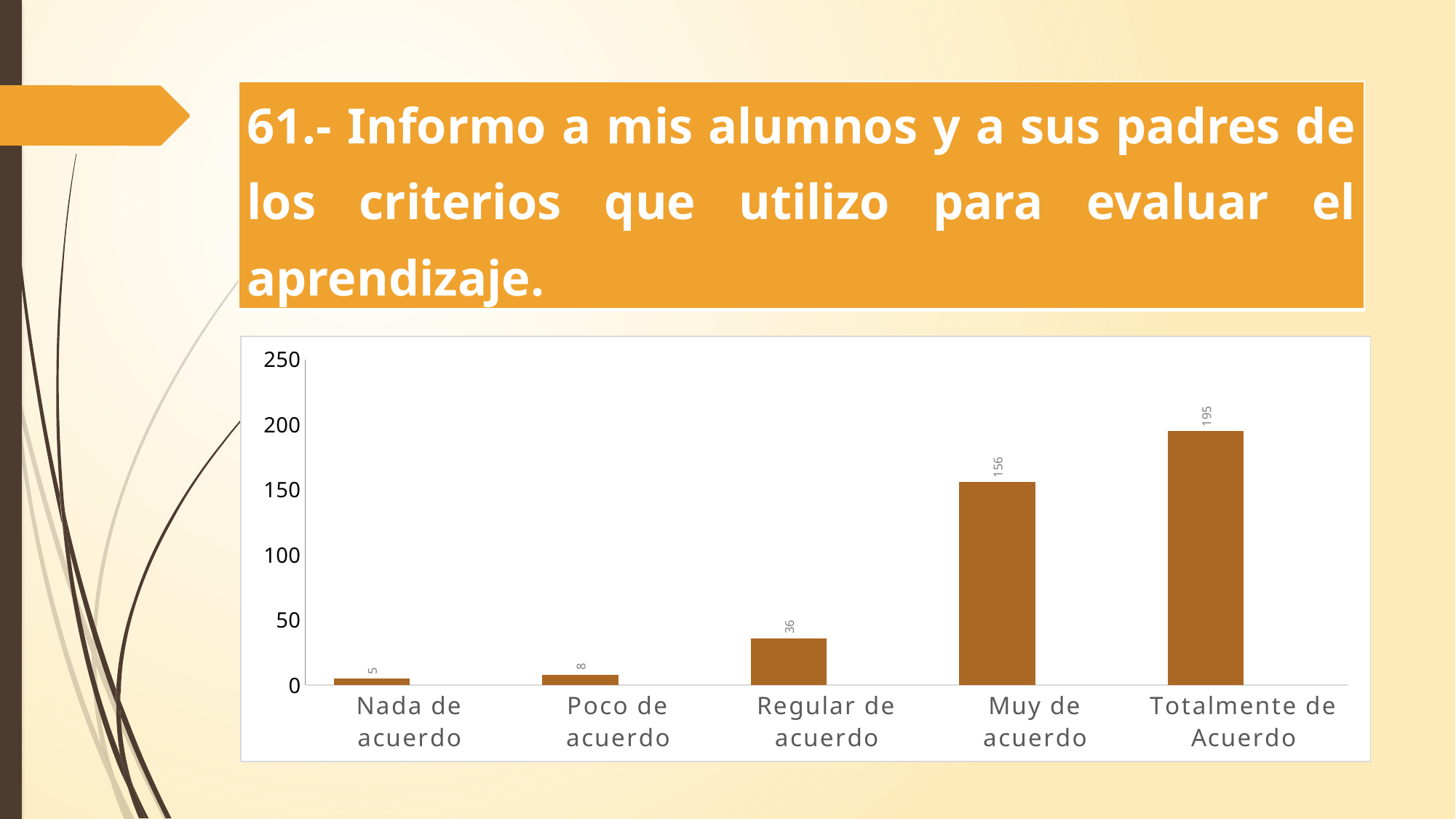
Is the value for "Muy de acuerdo" greater or less than 150? greater What is the value for "Muy de acuerdo"? 156 What is the value for "Poco de acuerdo"? 8 What is the value for "Nada de acuerdo"? 5 Which is larger, the value for "Regular de acuerdo" or the value for "Poco de acuerdo"? Regular de acuerdo What kind of chart is shown on the slide? bar chart What is the value for "Regular de acuerdo"? 36 Do the values rise or fall from left to right along the x axis? rise How many categories are shown on the x axis? 5 What is the difference between the values for "Totalmente de Acuerdo" and "Muy de acuerdo"? 39 Which category has the highest value? Totalmente de Acuerdo Which category has the lowest value? Nada de acuerdo